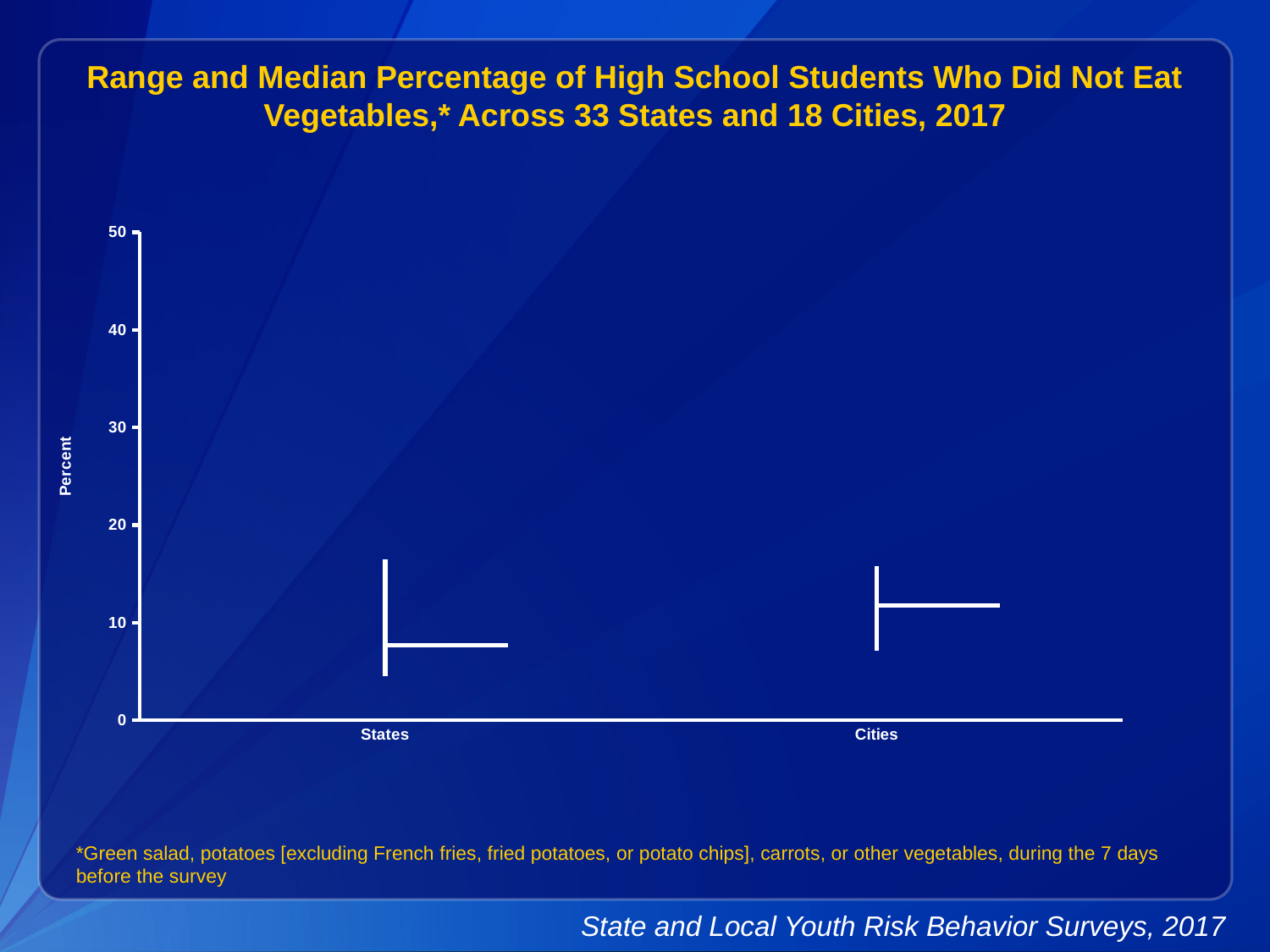
Is the top of the range for States greater or less than 20? less How many categories are shown on the x axis of the chart? 2 Is the top of the range for Cities greater or less than 20? less What is the label of the y axis? Percent Is the median value for Cities greater or less than 10? greater Which category has the higher median percentage, States or Cities? Cities Which category has the lower median percentage? States What is the highest value shown on the y axis? 50 What are the two categories shown on the x axis? States and Cities